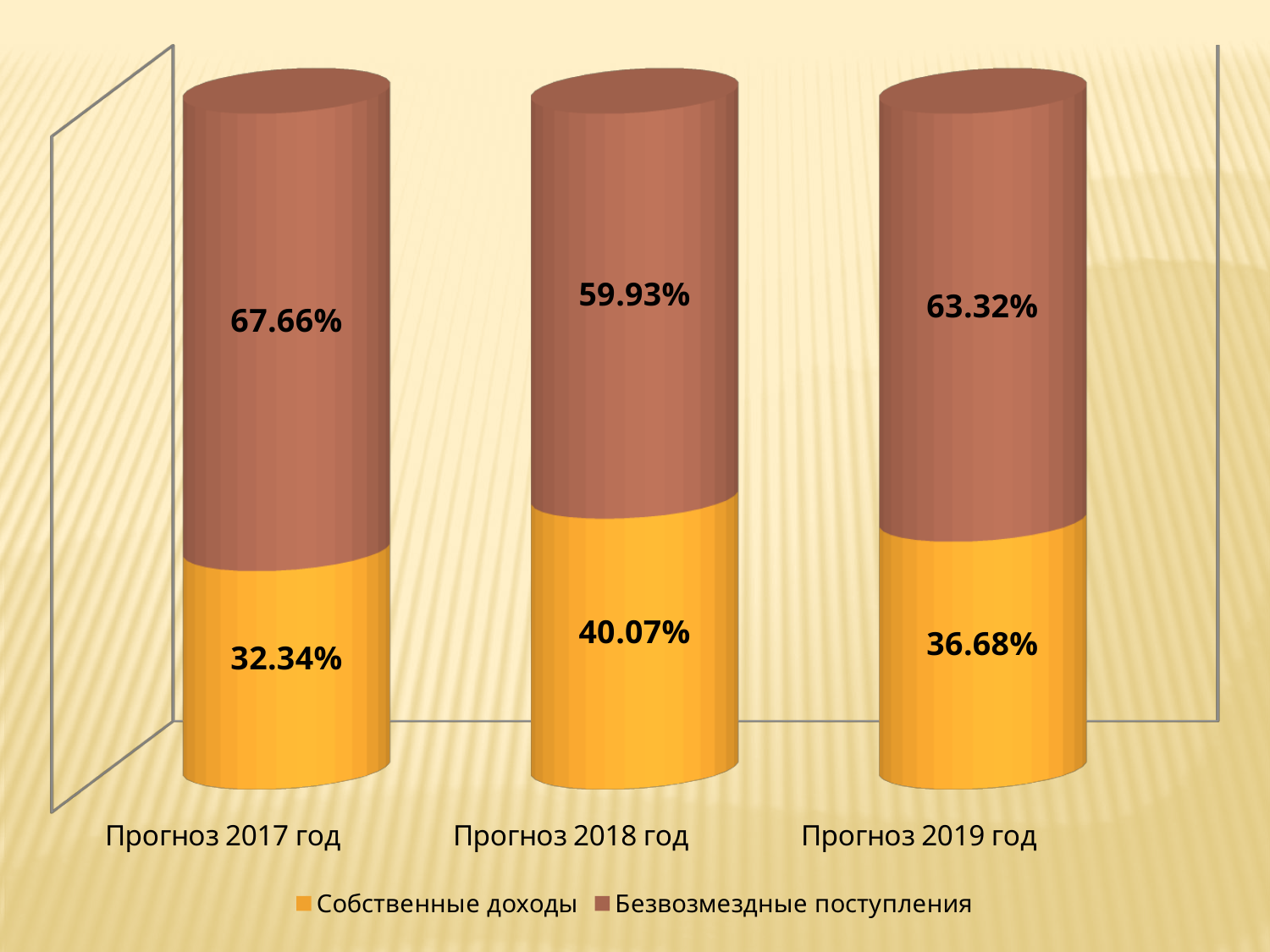
What is the value of Собственные доходы for Прогноз 2019 год? 36.68% What is the value of Безвозмездные поступления for Прогноз 2017 год? 67.66% How many categories are shown on the x axis? 3 Which colour represents Собственные доходы in the chart? Orange How many series does the legend list? 2 What is the value of Собственные доходы for Прогноз 2017 год? 32.34% Which category has the lowest value for Безвозмездные поступления? Прогноз 2018 год What is the value of Безвозмездные поступления for Прогноз 2018 год? 59.93% What kind of chart is shown on the slide? Stacked bar chart Which category has the highest value for Собственные доходы? Прогноз 2018 год Which is larger for Прогноз 2018 год: Собственные доходы or Безвозмездные поступления? Безвозмездные поступления What is the difference between Безвозмездные поступления and Собственные доходы for Прогноз 2019 год? 26.64%